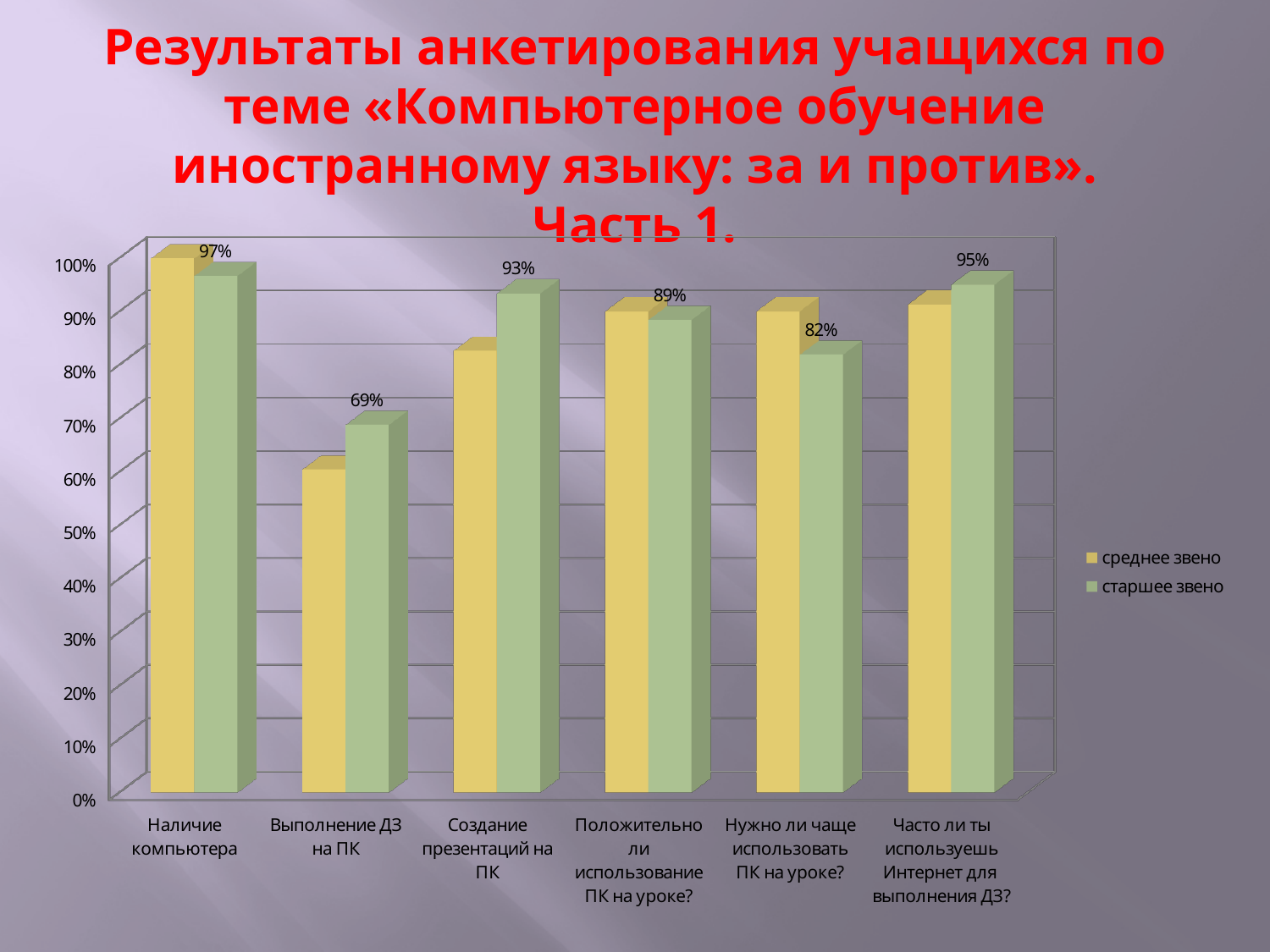
What is the value for старшее звено in the category Часто ли ты используешь Интернет для выполнения ДЗ? 95% What is the value for старшее звено in the category Нужно ли чаще использовать ПК на уроке? 82% Is the value for среднее звено in the category Выполнение ДЗ на ПК greater or less than 70%? less What kind of chart is shown on the slide? bar chart What is the value for старшее звено in the category Выполнение ДЗ на ПК? 69% In which category does старшее звено have the highest value? Наличие компьютера How many categories are shown on the x axis? 6 In which category does старшее звено have the lowest value? Выполнение ДЗ на ПК How many series does the legend list? 2 What is the value for старшее звено in the category Создание презентаций на ПК? 93% For старшее звено, which is larger: Создание презентаций на ПК or Положительно ли использование ПК на уроке? Создание презентаций на ПК What is the difference between the старшее звено values for Наличие компьютера and Выполнение ДЗ на ПК? 28%